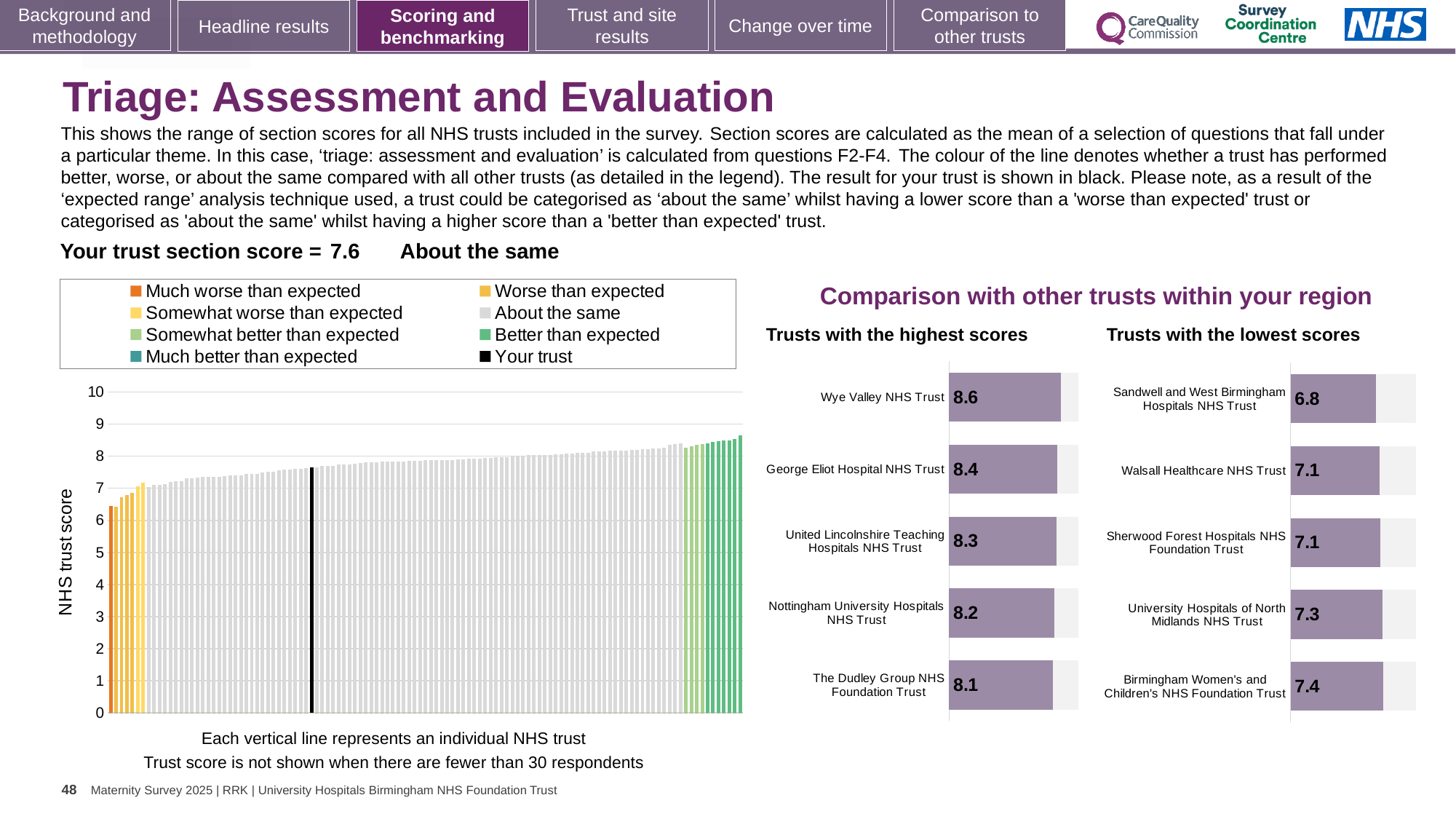
In the main 'NHS trust score' chart on the left, do the bar heights rise or fall from left to right? rise How many entries does the legend of the main 'NHS trust score' chart list? 8 In the 'Trusts with the highest scores' chart, which trust has the highest score? Wye Valley NHS Trust In the 'Trusts with the lowest scores' chart, which trust has the lowest score? Sandwell and West Birmingham Hospitals NHS Trust How many trusts are shown in the 'Trusts with the lowest scores' chart? 5 In the 'Trusts with the lowest scores' chart, which has the larger score: Sandwell and West Birmingham Hospitals NHS Trust or Birmingham Women's and Children's NHS Foundation Trust? Birmingham Women's and Children's NHS Foundation Trust In the 'Trusts with the highest scores' chart, what is the score for Wye Valley NHS Trust? 8.6 In the 'Trusts with the highest scores' chart, what is the score for The Dudley Group NHS Foundation Trust? 8.1 In the main 'NHS trust score' chart on the left, what is the section score for your trust? 7.6 In the 'Trusts with the highest scores' chart, what is the difference between the scores of Wye Valley NHS Trust and The Dudley Group NHS Foundation Trust? 0.5 In the 'Trusts with the lowest scores' chart, what is the score for Sandwell and West Birmingham Hospitals NHS Trust? 6.8 What kind of chart is the 'Trusts with the highest scores' chart? bar chart